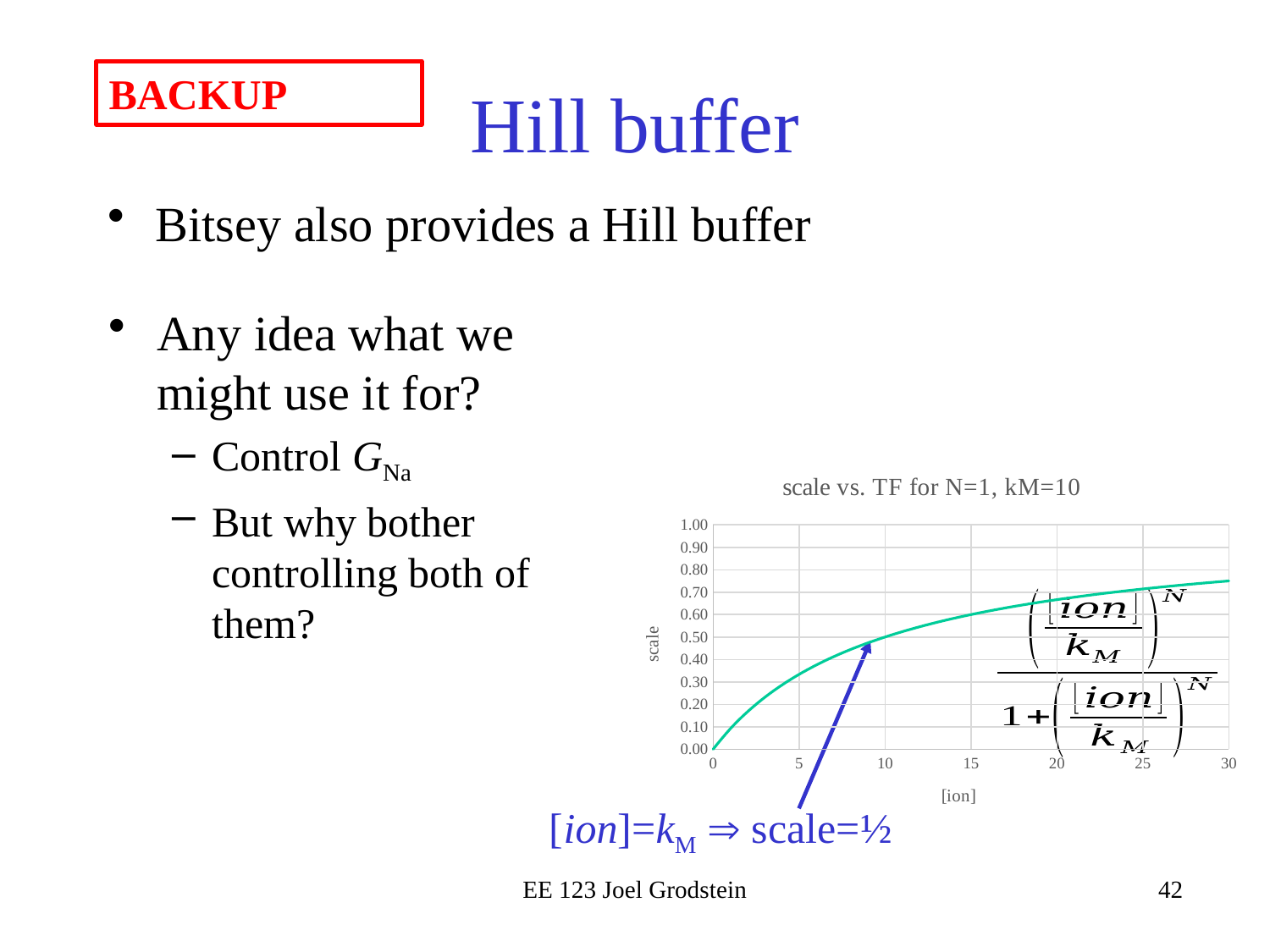
Is the scale value at [ion]=5 greater or less than 0.40? less What is the highest value shown on the y axis of the chart? 1.00 Is the scale value at [ion]=30 greater or less than 0.70? greater What is the title of the chart? scale vs. TF for N=1, kM=10 Is the scale value at [ion]=20 greater or less than 0.60? greater How many lines are plotted on the chart? 1 Which has the larger scale value on the chart: [ion]=5 or [ion]=25? [ion]=25 What kind of chart is shown on the slide? line chart What is the label of the x axis of the chart? [ion] According to the annotation on the chart, what is the scale value when [ion] equals kM? ½ Does the plotted scale value rise or fall as [ion] increases from 0 to 30? rise